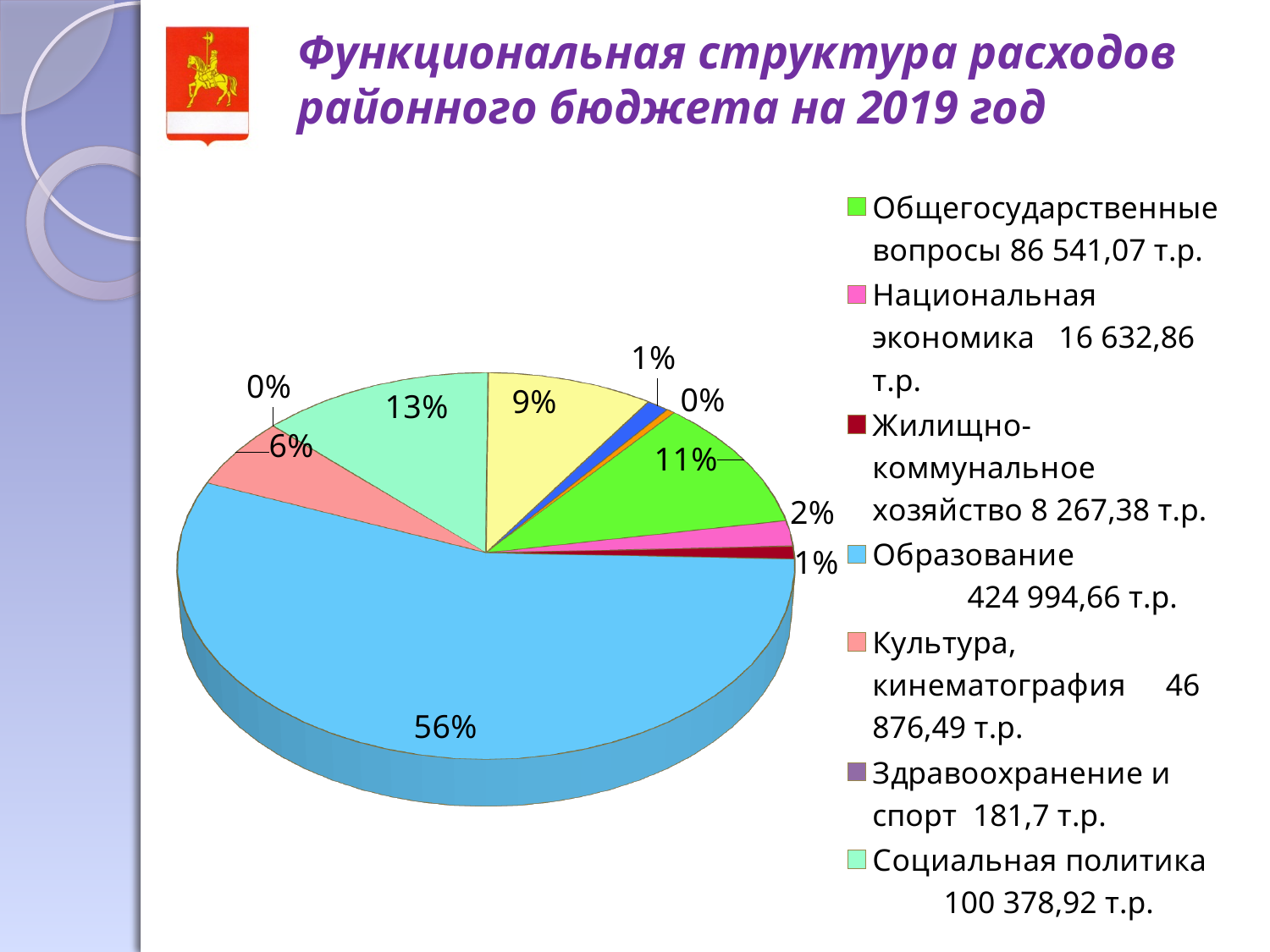
What share of the pie does Социальная политика take? 13% What share of the pie does Образование take? 56% By how many percentage points does the Образование share exceed the Социальная политика share? 43 What share of the pie does Общегосударственные вопросы take? 11% According to the legend, what amount is given for Образование? 424 994,66 т.р. Which category has the largest slice of the pie? Образование What kind of chart is shown on the slide? pie chart What is the title of the slide? Функциональная структура расходов районного бюджета на 2019 год Which slice is larger: Социальная политика or Общегосударственные вопросы? Социальная политика According to the legend, what amount is given for Социальная политика? 100 378,92 т.р.